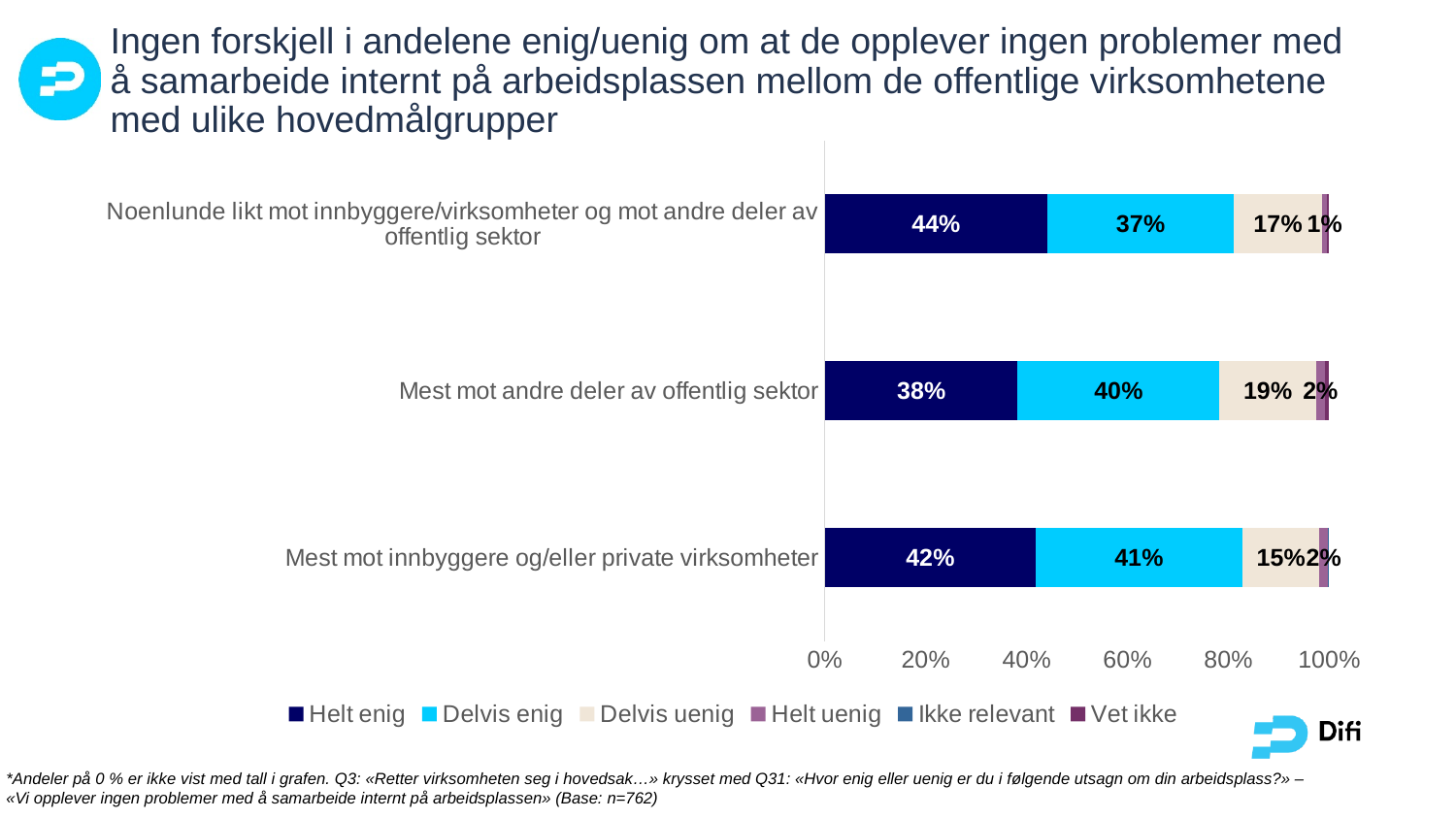
How many series does the legend list? 6 What is the difference between the 'Helt enig' shares for 'Noenlunde likt mot innbyggere/virksomheter og mot andre deler av offentlig sektor' and 'Mest mot andre deler av offentlig sektor'? 6 percentage points Which is larger for 'Mest mot andre deler av offentlig sektor': the 'Helt enig' share or the 'Delvis enig' share? Delvis enig How many categories (bars) does the chart show? 3 What is the 'Helt enig' share for 'Noenlunde likt mot innbyggere/virksomheter og mot andre deler av offentlig sektor'? 44% What is the 'Helt enig' share for 'Mest mot andre deler av offentlig sektor'? 38% What is the 'Delvis enig' share for 'Mest mot innbyggere og/eller private virksomheter'? 41% Which category has the lowest 'Delvis uenig' share? Mest mot innbyggere og/eller private virksomheter What kind of chart is shown on the slide? Stacked bar chart Which category has the highest 'Helt enig' share? Noenlunde likt mot innbyggere/virksomheter og mot andre deler av offentlig sektor What is the first series listed in the legend? Helt enig What is the 'Delvis uenig' share for 'Noenlunde likt mot innbyggere/virksomheter og mot andre deler av offentlig sektor'? 17%